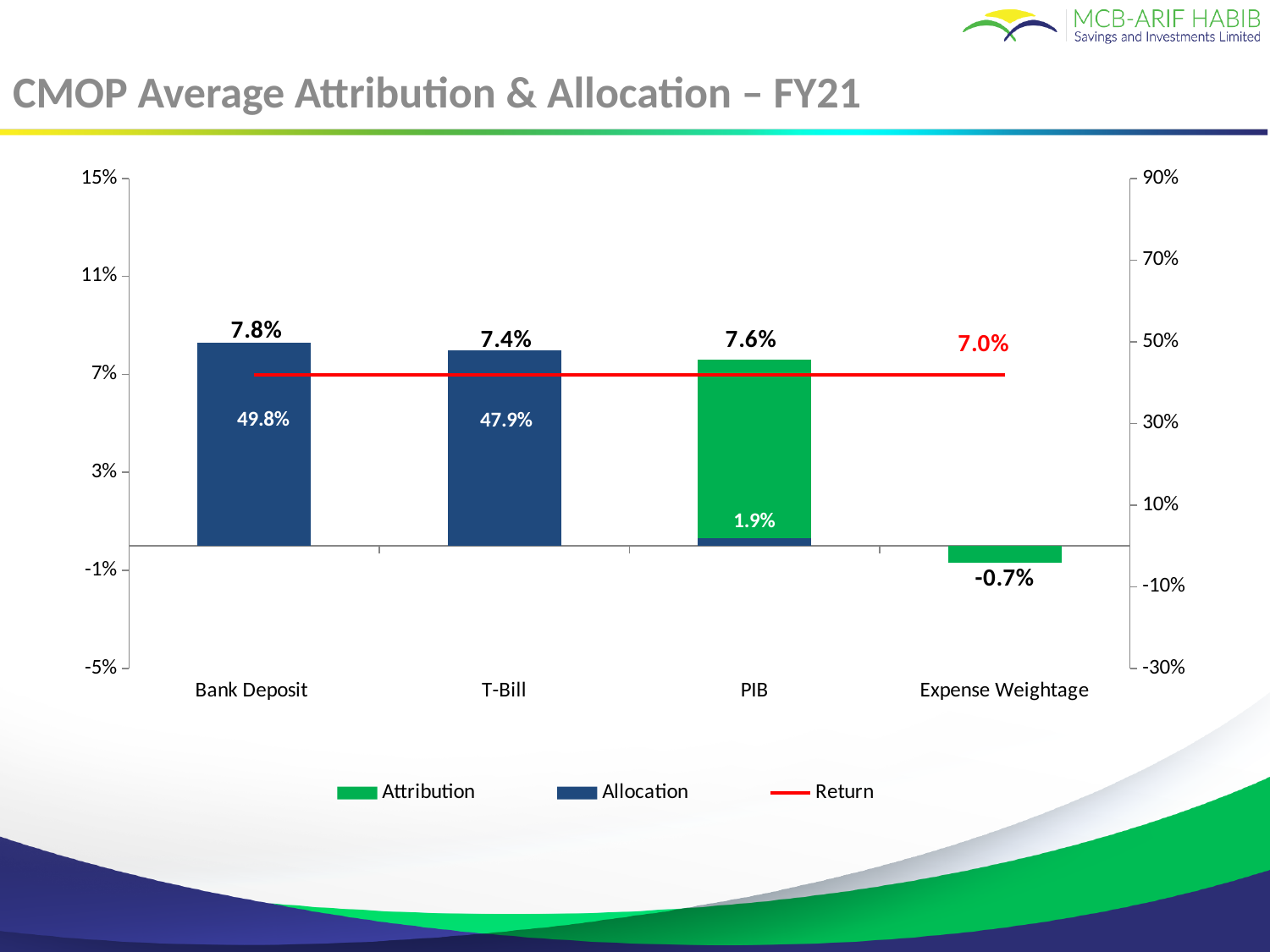
What value is shown for the Return line? 7.0% What is the Allocation value for PIB? 1.9% What is the difference between the Allocation values for Bank Deposit and T-Bill? 1.9% What is the Attribution value for Bank Deposit? 7.8% How many series does the legend list? 3 How many categories are shown on the x axis? 4 What is the Attribution value for Expense Weightage? -0.7% What is the Attribution value for PIB? 7.6% What is the Attribution value for T-Bill? 7.4% Which category has the highest Attribution value? Bank Deposit Which category has the lowest Attribution value? Expense Weightage What is the Allocation value for Bank Deposit? 49.8%